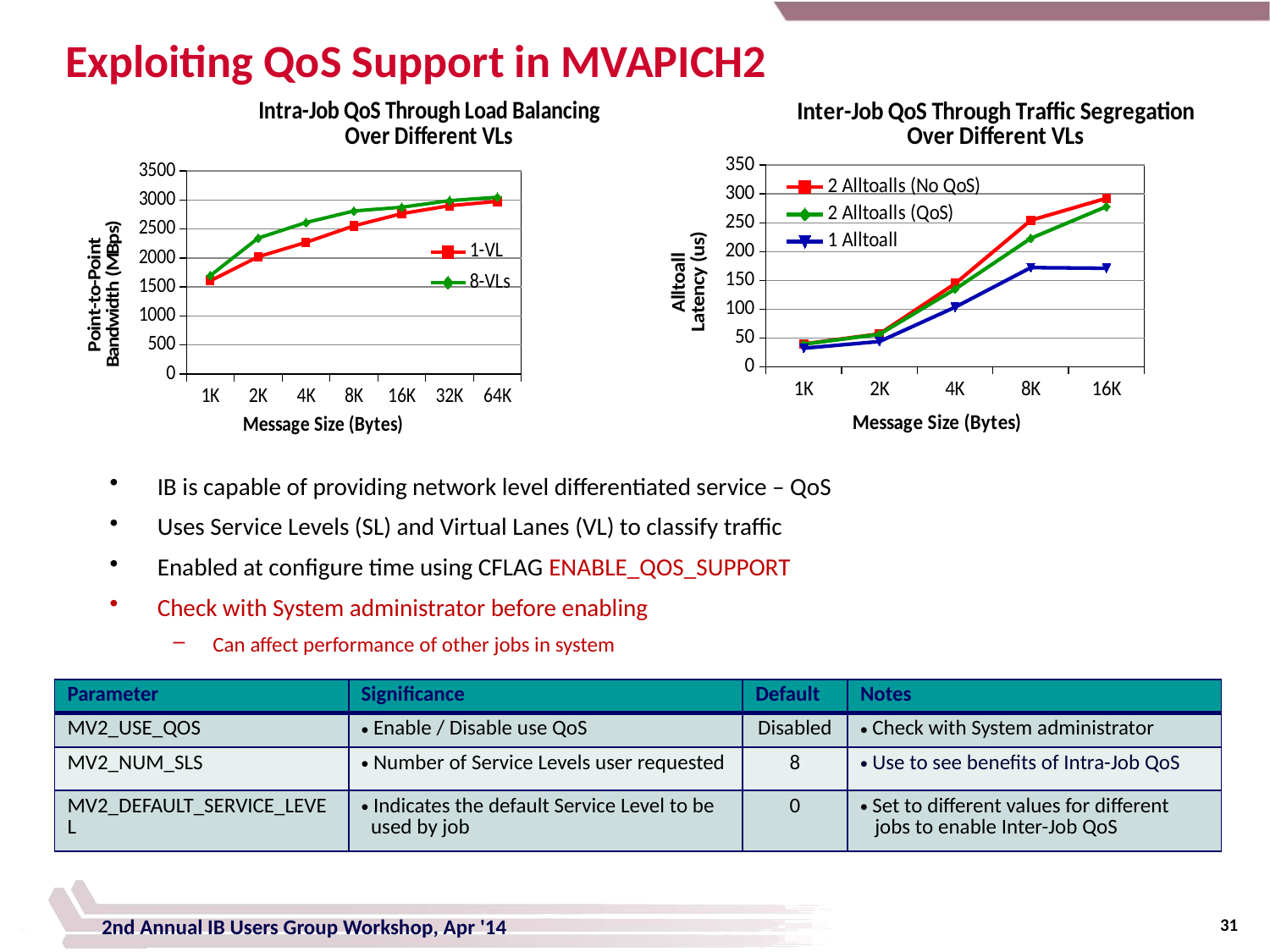
In the 'Inter-Job QoS Through Traffic Segregation Over Different VLs' chart, how many message sizes are plotted on the x axis? 5 In the 'Inter-Job QoS Through Traffic Segregation Over Different VLs' chart, which series has the lowest latency at 16K bytes? 1 Alltoall In the 'Intra-Job QoS Through Load Balancing Over Different VLs' chart, does the 1-VL bandwidth rise or fall as message size increases? rise In the 'Intra-Job QoS Through Load Balancing Over Different VLs' chart, what kind of chart is shown? line chart In the 'Inter-Job QoS Through Traffic Segregation Over Different VLs' chart, which series has the highest latency at 8K bytes? 2 Alltoalls (No QoS) In the 'Inter-Job QoS Through Traffic Segregation Over Different VLs' chart, what is the label of the y axis? Alltoall Latency (us) In the 'Inter-Job QoS Through Traffic Segregation Over Different VLs' chart, is the value for 1 Alltoall at 16K greater or less than 150? greater In the 'Intra-Job QoS Through Load Balancing Over Different VLs' chart, how many message sizes are plotted on the x axis? 7 In the 'Intra-Job QoS Through Load Balancing Over Different VLs' chart, how many series does the legend list? 2 In the 'Intra-Job QoS Through Load Balancing Over Different VLs' chart, which series has the higher bandwidth at 2K bytes, 1-VL or 8-VLs? 8-VLs In the 'Intra-Job QoS Through Load Balancing Over Different VLs' chart, is the value for 8-VLs at 2K greater or less than 2000? greater In the 'Inter-Job QoS Through Traffic Segregation Over Different VLs' chart, how many series does the legend list? 3